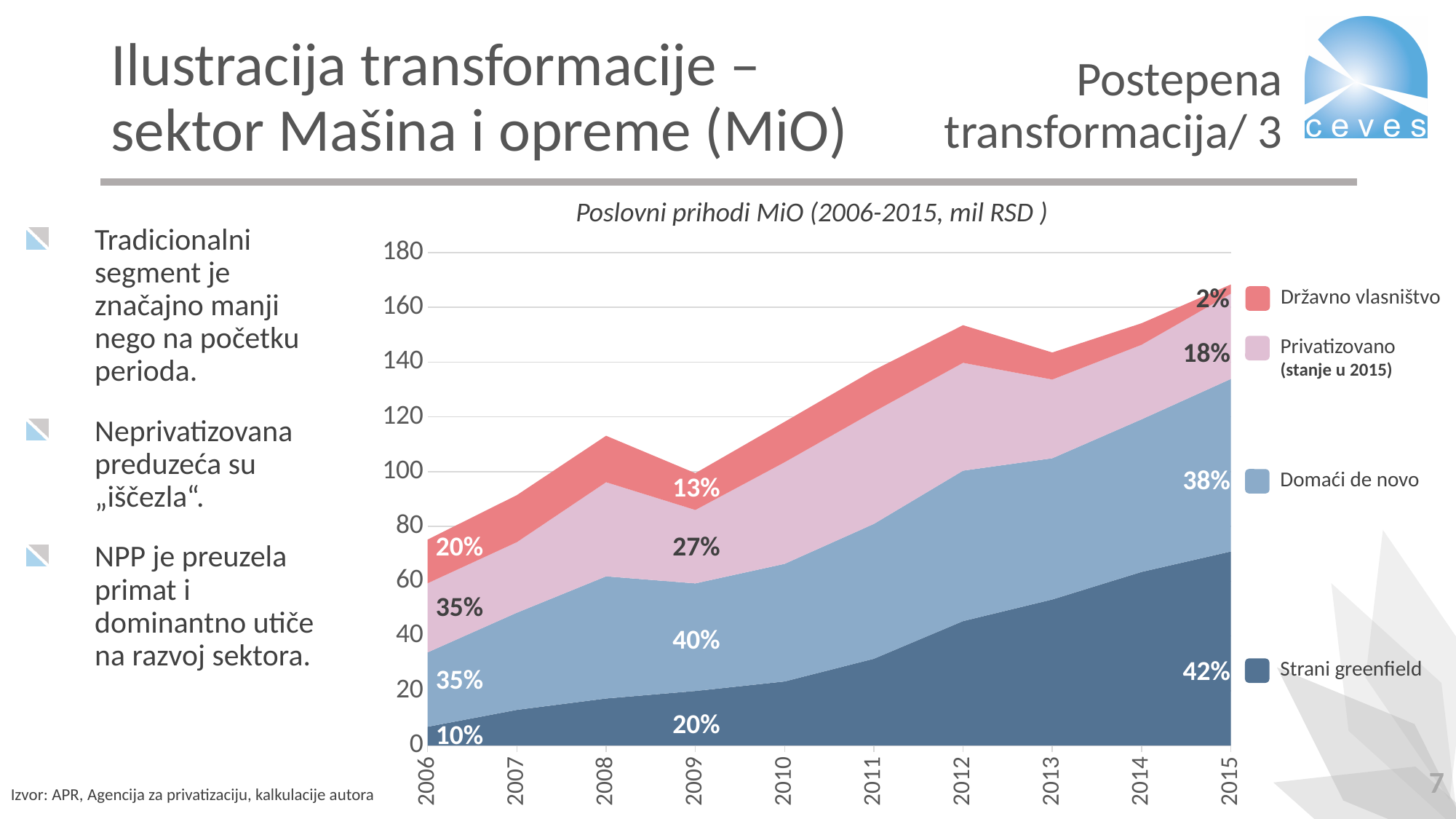
What kind of chart is shown on the slide? Stacked area chart What percentage share is labelled for Strani greenfield in 2006? 10% How many series does the legend list? 4 What percentage share is labelled for Privatizovano in 2015? 18% What percentage share is labelled for Domaći de novo in 2009? 40% What is the title of the chart? Poslovni prihodi MiO (2006-2015, mil RSD ) Is the total value for 2006 greater or less than 80? less Is the total value for 2015 greater or less than 160? greater How many years are shown on the x axis of the chart? 10 What percentage share is labelled for Državno vlasništvo in 2009? 13% What percentage share is labelled for Državno vlasništvo in 2015? 2% Does the total value generally rise or fall from 2006 to 2015? Rise